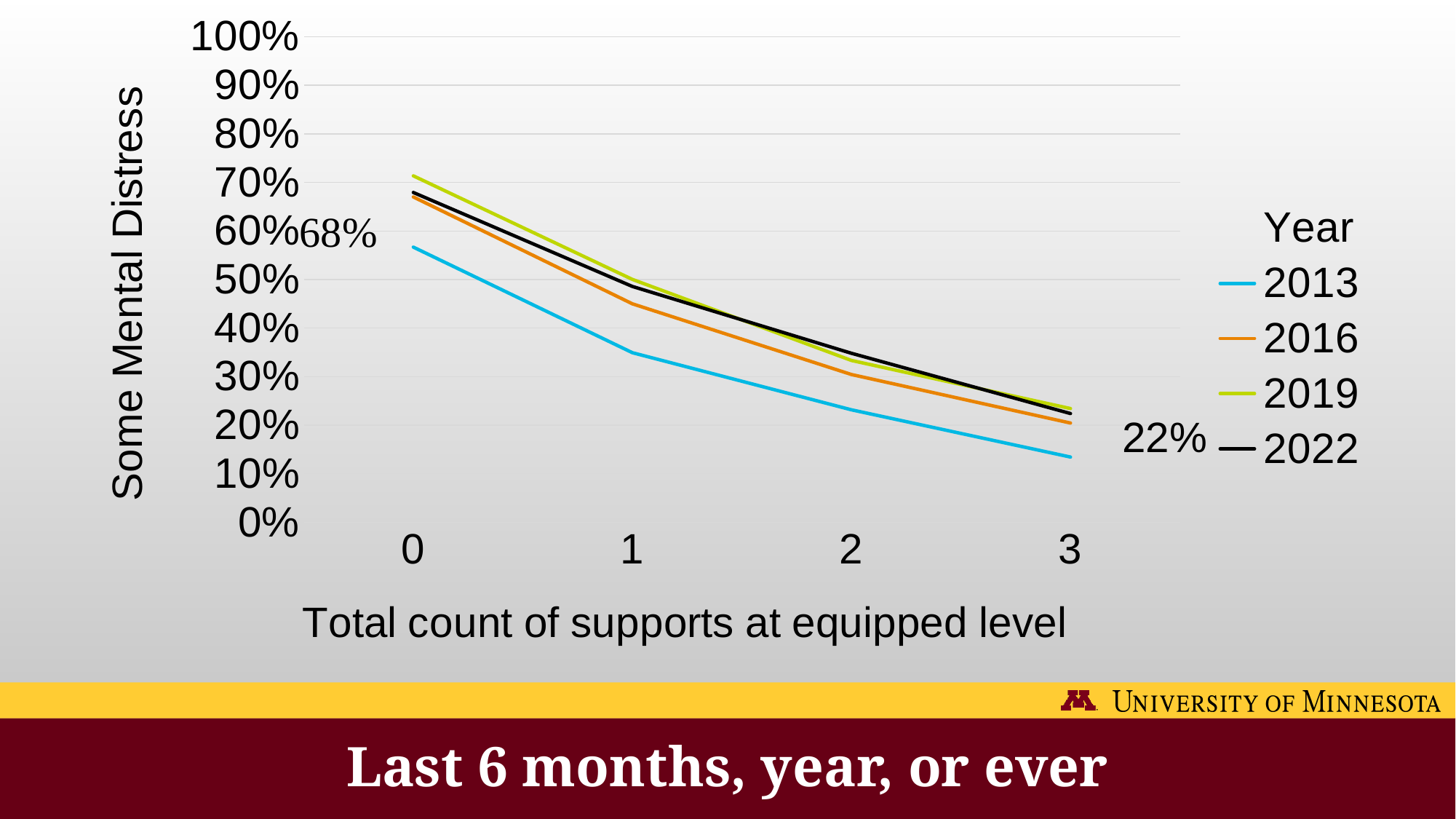
What is the title of the legend? Year Do the values for the 2013 series rise or fall as the total count of supports increases from 0 to 3? fall What is the label on the y axis? Some Mental Distress Is the value for 2016 at a total count of supports of 1 greater or less than 50%? less At a total count of supports of 2, which is larger: the value for 2013 or the value for 2019? 2019 Which year has the highest value at a total count of supports of 0? 2019 How many points along the x axis (total count of supports) are plotted for each series? 4 What kind of chart is shown on the slide? line chart Which year has the lowest value at a total count of supports of 3? 2013 Is the value for 2013 at a total count of supports of 0 greater or less than 50%? greater How many series does the legend list? 4 Is the value for 2013 at a total count of supports of 3 greater or less than 20%? less